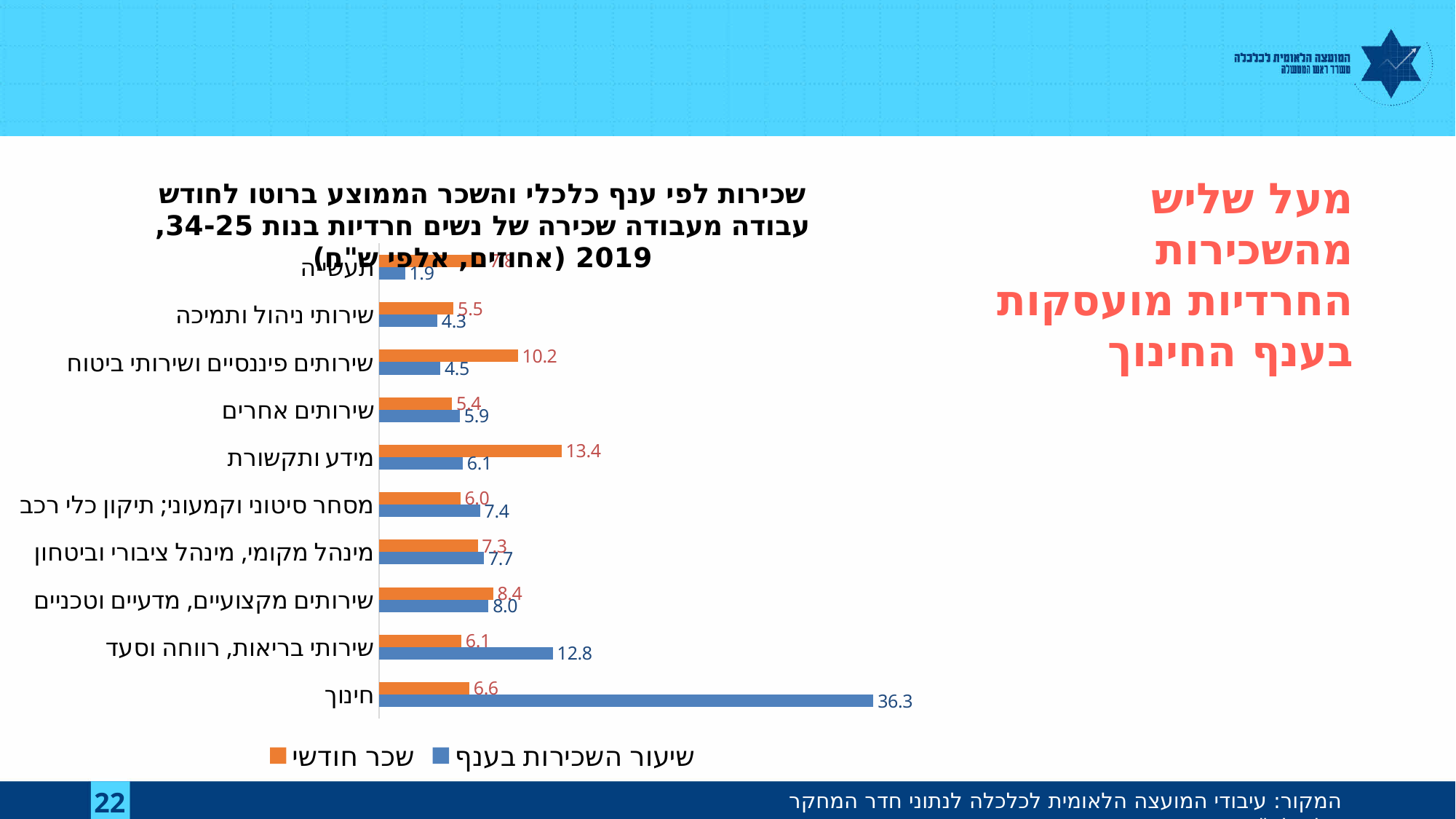
Which category has the highest value of שכר חודשי? מידע ותקשורת Which category has the highest value of שיעור השכירות בענף? חינוך How many series does the legend list? 2 What is the difference between the שיעור השכירות בענף values for חינוך and שירותי בריאות, רווחה וסעד? 23.5 Which series is shown in orange in the legend? שכר חודשי What is the value of שיעור השכירות בענף for חינוך? 36.3 Which is larger for שירותים פיננסיים ושירותי ביטוח: שכר חודשי or שיעור השכירות בענף? שכר חודשי What type of chart is shown on the slide? bar chart What is the difference between the שכר חודשי and שיעור השכירות בענף values for מידע ותקשורת? 7.3 What is the value of שכר חודשי for שירותים פיננסיים ושירותי ביטוח? 10.2 What is the value of שיעור השכירות בענף for שירותי בריאות, רווחה וסעד? 12.8 What is the value of שכר חודשי for מידע ותקשורת? 13.4